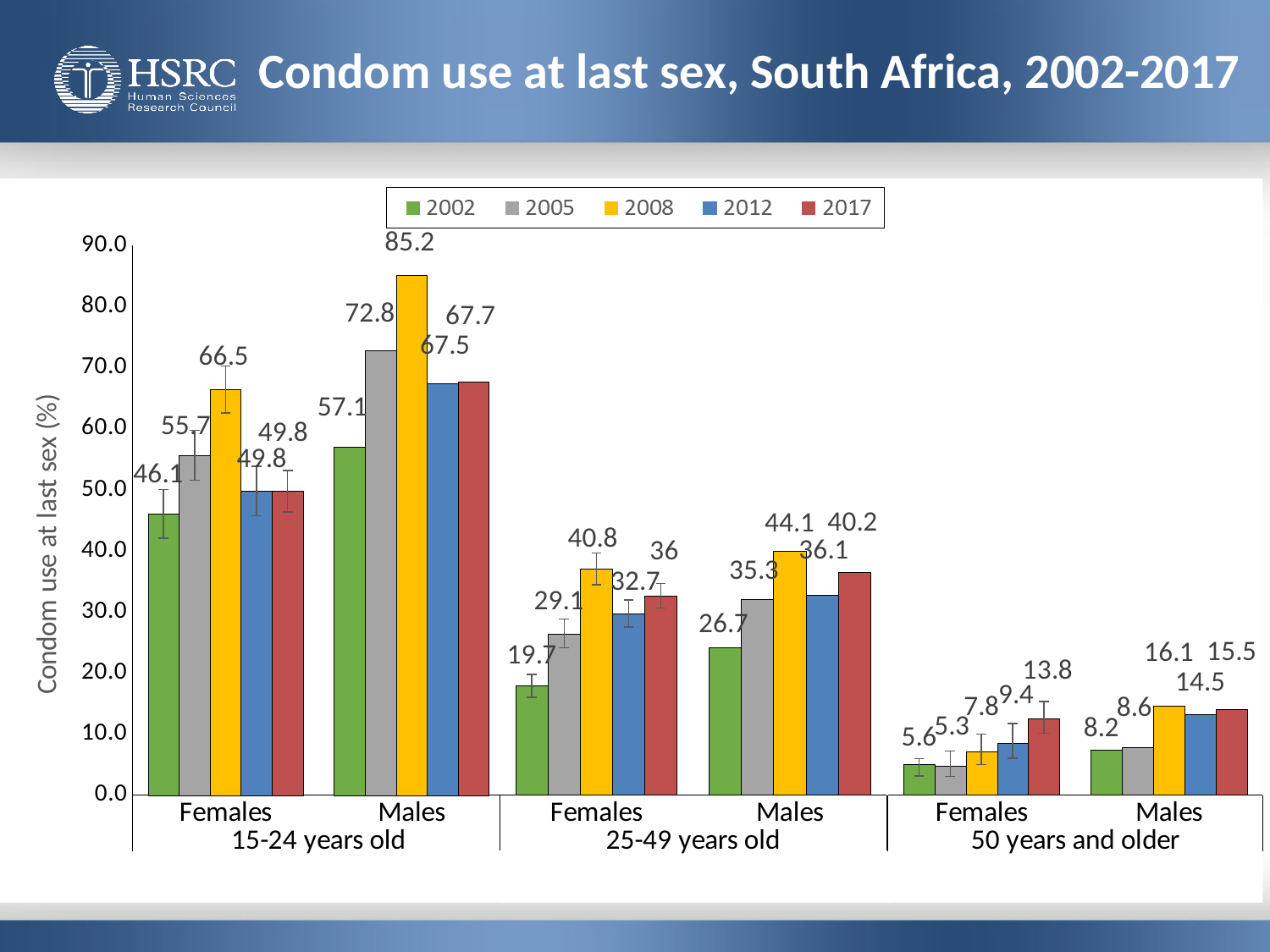
Which is larger: the 2005 value for Females aged 15-24 or the 2008 value for Males aged 25-49? 2005 value for Females aged 15-24 Is the 2005 value for Males aged 15-24 years old greater or less than 70.0? greater Do the values for Females aged 50 years and older rise or fall from 2008 to 2017? rise Which year has the lowest value for Females aged 25-49 years old? 2002 How many years does the legend list? 5 What is the 2017 value for Females aged 50 years and older? 13.8 What is the 2002 value for Females aged 25-49 years old? 19.7 What is the difference between the 2008 and 2002 values for Males aged 15-24 years old? 28.1 Which year has the highest value for Females aged 25-49 years old? 2008 How many age groups are shown on the x axis? 3 What is the 2008 value for Males aged 15-24 years old? 85.2 What kind of chart is shown on the slide? bar chart